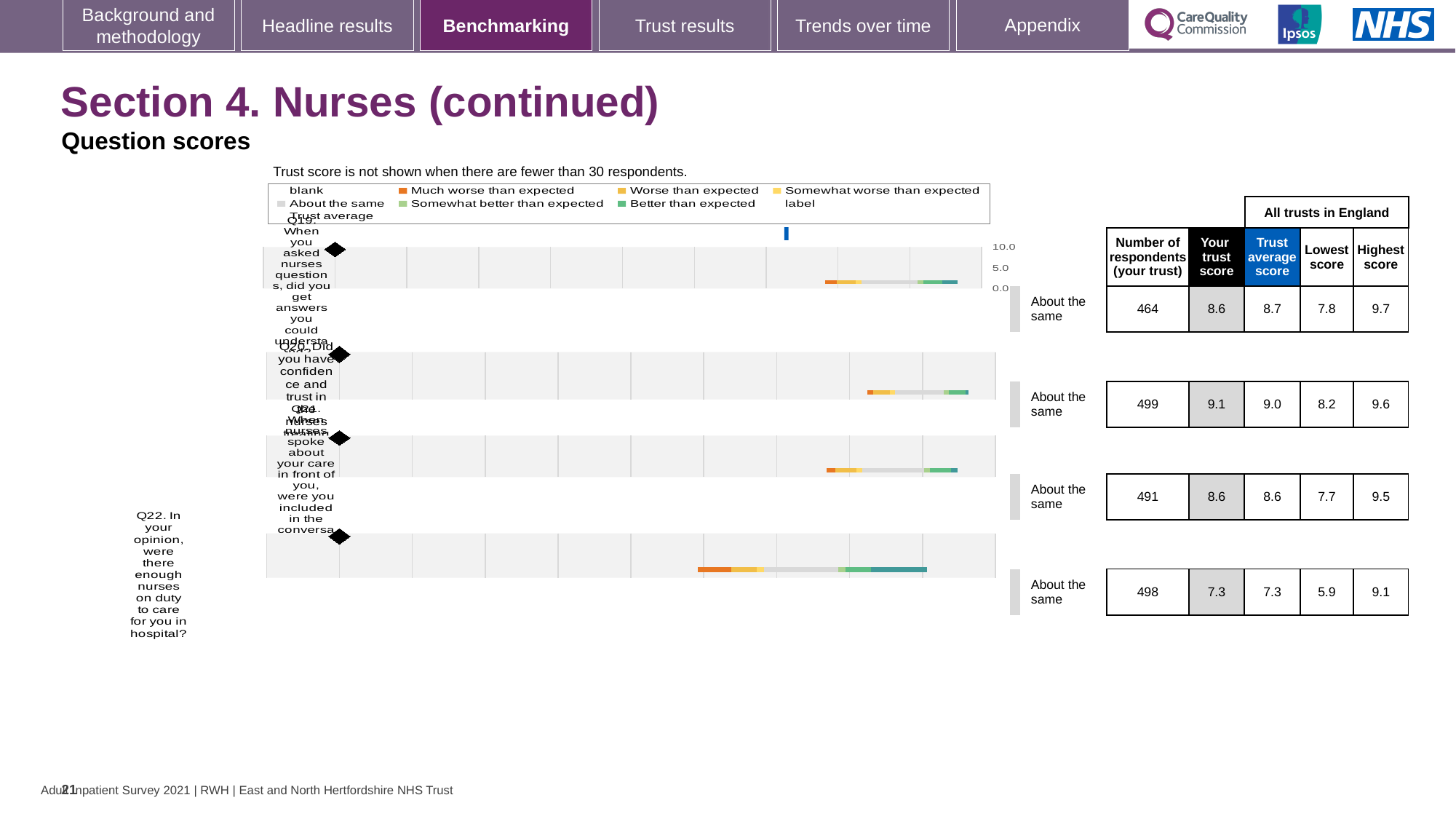
How many questions (categories) are plotted in the chart? 4 What kind of chart is used to show the question scores on this slide? bar chart What is the difference between the highest and lowest scores across all trusts in England for Q22? 3.2 What benchmark category label is shown next to each of the four questions? About the same What is the difference between the highest score and the lowest score across all trusts in England for Q19? 1.9 What is the 'Your trust score' for Q22 (enough nurses on duty)? 7.3 How many respondents from the trust answered Q20 (confidence and trust in nurses)? 499 Which question has the highest 'Your trust score'? Q20 What is the lowest score across all trusts in England for Q21? 7.7 What is the highest score across all trusts in England for Q22? 9.1 For Q19, which is larger: the trust's own score or the trust average score? Trust average score Which question has the lowest 'Your trust score'? Q22